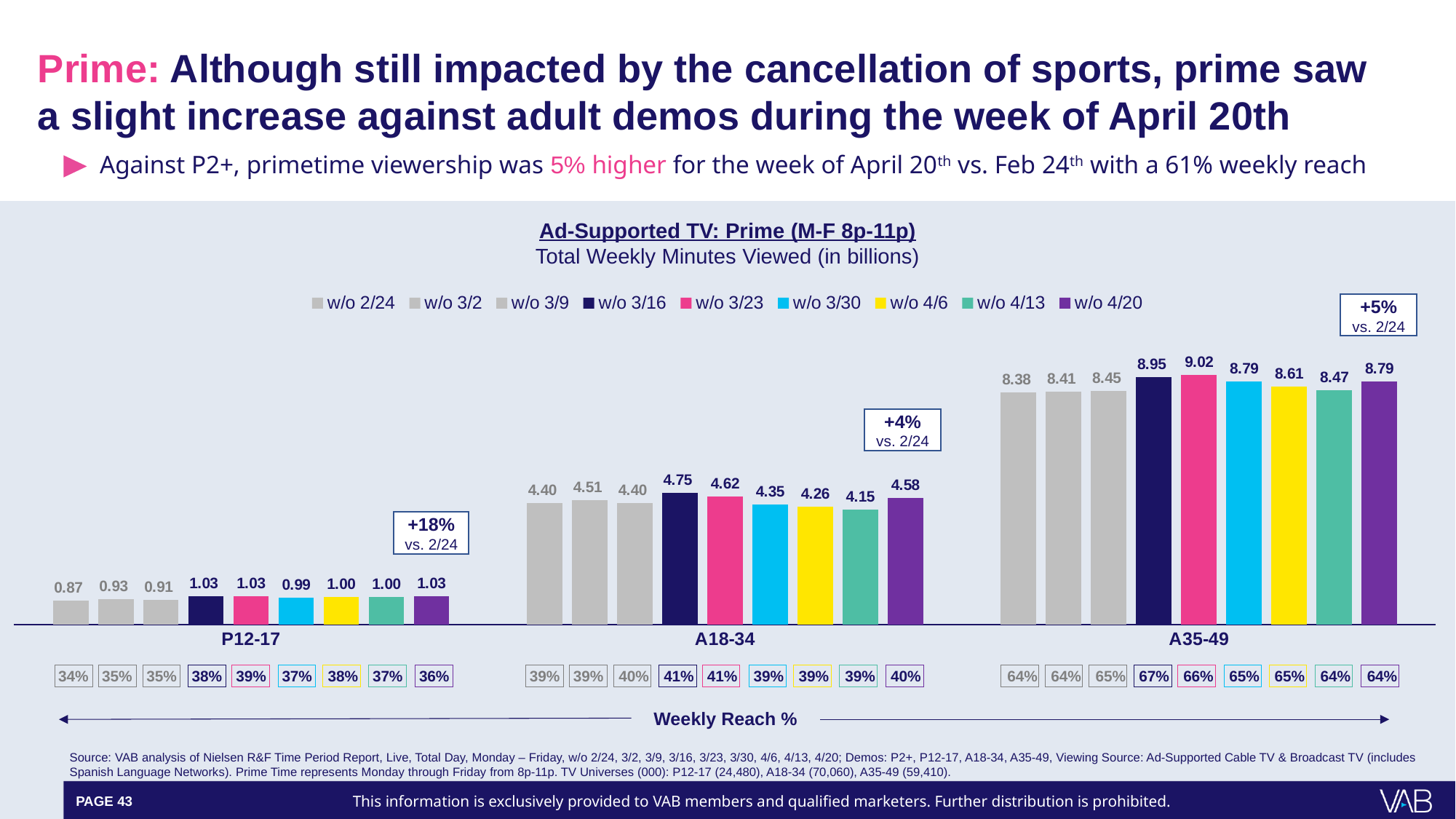
What percentage change vs. 2/24 is annotated for the P12-17 group? +18% For A18-34, which week has the highest total weekly minutes viewed? w/o 3/16 What is the difference between the w/o 4/20 and w/o 4/13 values for A18-34? 0.43 What is the value for P12-17 in the w/o 2/24 series? 0.87 What kind of chart is shown on the slide? Bar chart What is the weekly reach % for A35-49 in the w/o 3/16 week? 67% For A35-49, which week has the lowest total weekly minutes viewed? w/o 2/24 What is the value for A35-49 in the w/o 3/23 series? 9.02 How many demo categories are shown on the x axis? 3 For A35-49, which is larger: the w/o 3/30 value or the w/o 4/6 value? w/o 3/30 How many series does the legend list? 9 What is the title of the chart? Ad-Supported TV: Prime (M-F 8p-11p)